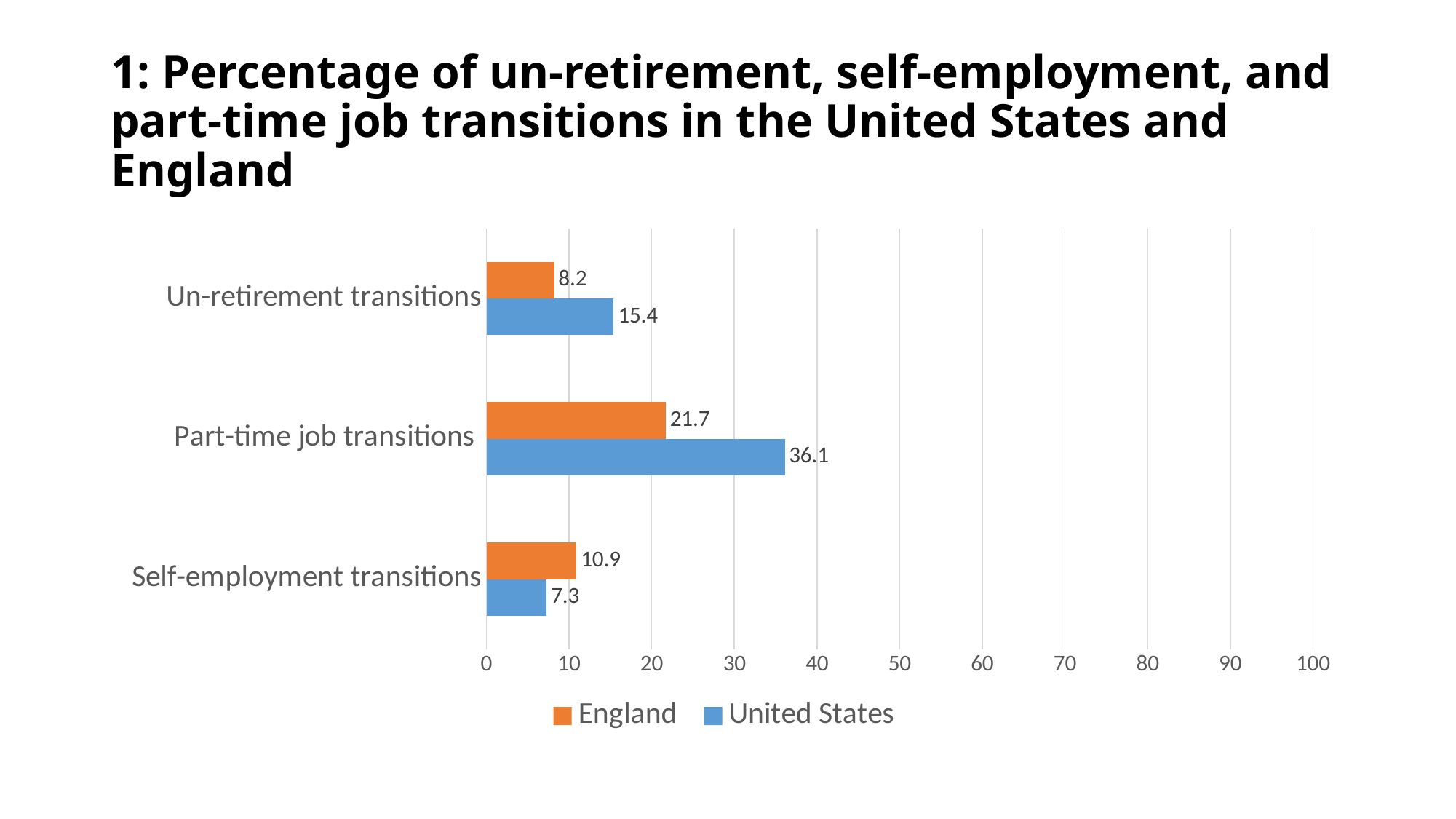
What is the value for the United States for Un-retirement transitions? 15.4 How many series does the legend list? 2 What is the value for the United States for Self-employment transitions? 7.3 Is the value for the United States for Part-time job transitions greater or less than 30? greater What is the difference between the United States and England values for Part-time job transitions? 14.4 Which category has the lowest value for England? Un-retirement transitions How many categories are shown on the chart? 3 What is the value for England for Un-retirement transitions? 8.2 For Self-employment transitions, which is larger: England or the United States? England What is the value for England for Part-time job transitions? 21.7 Which category has the highest value for the United States? Part-time job transitions What kind of chart is shown on the slide? Bar chart